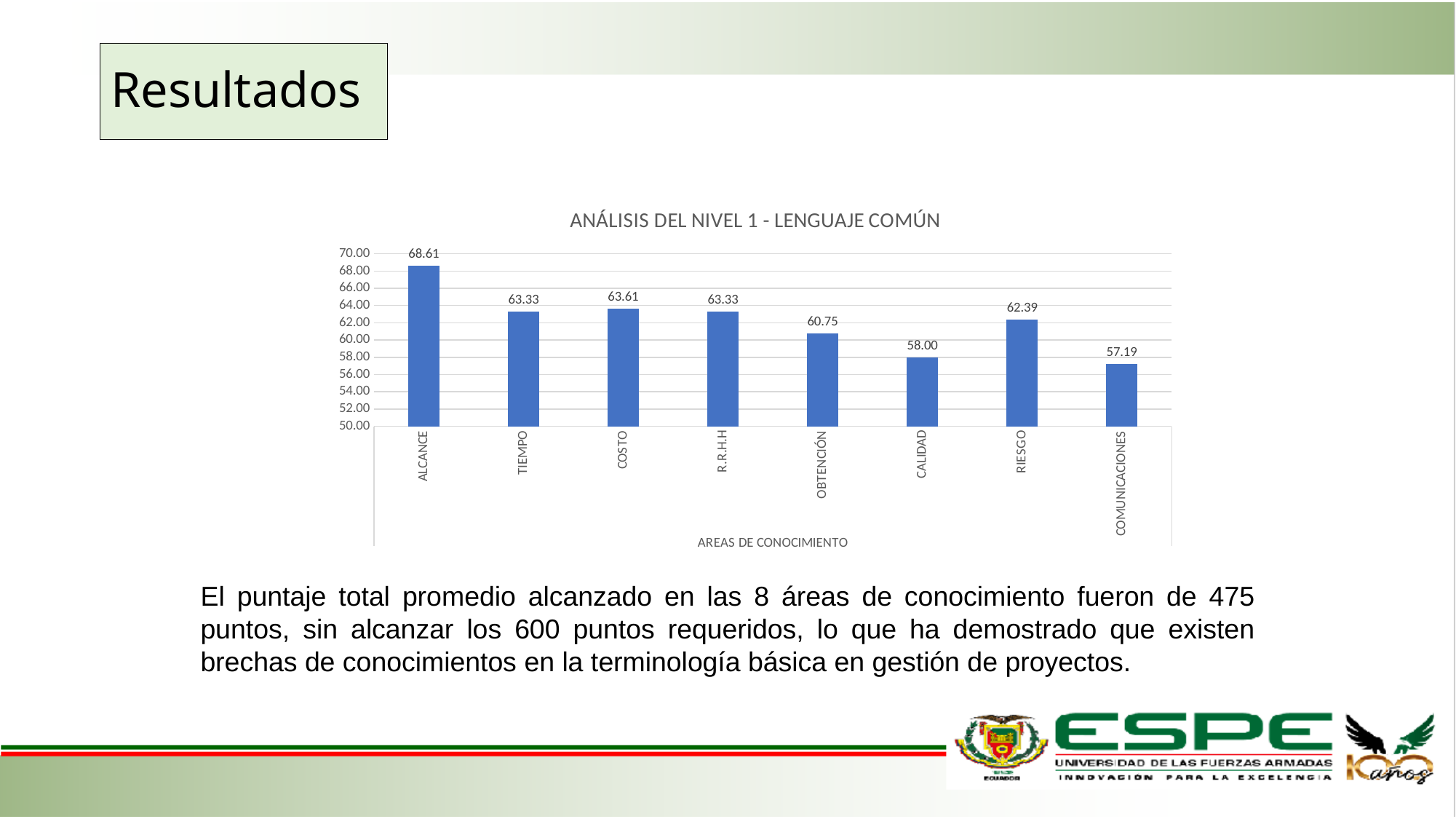
Which area has the lowest value? COMUNICACIONES How many areas of knowledge are shown on the x axis? 8 What is the title of the chart? ANÁLISIS DEL NIVEL 1 - LENGUAJE COMÚN Which area has the highest value? ALCANCE What kind of chart is shown on the slide? bar chart What is the value for ALCANCE? 68.61 Is the value for CALIDAD greater or less than 60.00? less What is the value for COMUNICACIONES? 57.19 What is the difference between the values for ALCANCE and CALIDAD? 10.61 What is the value for OBTENCIÓN? 60.75 What is the value for RIESGO? 62.39 Which is larger, the value for COSTO or the value for OBTENCIÓN? COSTO